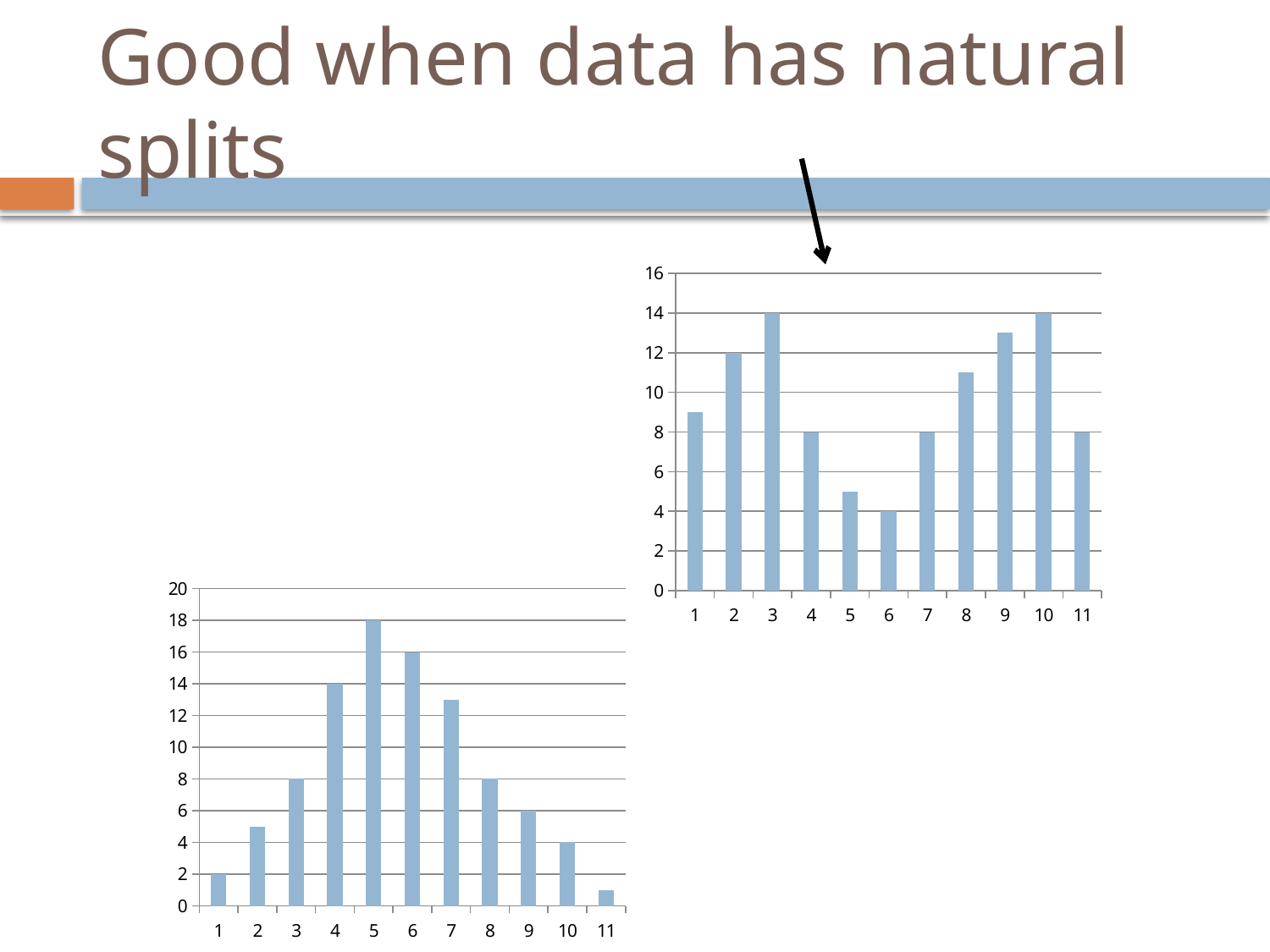
In the chart at the top right, which category has the shortest bar? 6 In the chart at the top right, what is the value for category 6? 4 What kind of chart is the chart at the bottom left of the slide? bar chart In the chart at the bottom left, what is the value for category 1? 2 In the chart at the bottom left, which category has the tallest bar? 5 In the chart at the top right, is the value for category 1 greater or less than 8? greater In the chart at the bottom left, what is the value for category 5? 18 In the chart at the bottom left, what is the difference between the values for category 5 and category 6? 2 In the chart at the top right, what is the value for category 3? 14 In the chart at the bottom left, which category has the shortest bar? 11 How many bars does the chart at the top right of the slide have? 11 In the chart at the bottom left, which is larger, the value for category 4 or the value for category 7? category 4